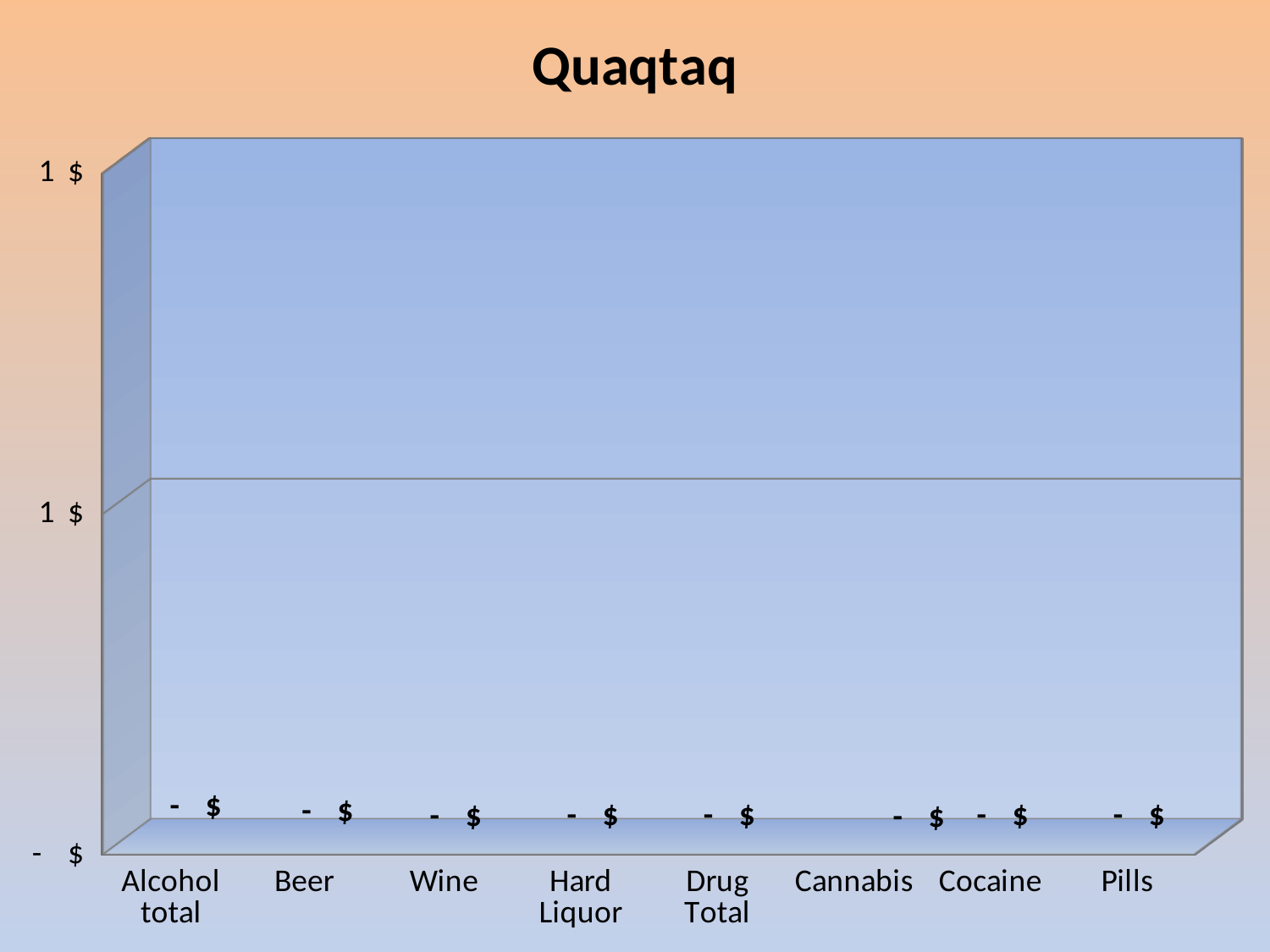
What value is labelled for Hard Liquor? - $ How many categories are shown on the x axis of the chart? 8 What value is labelled for Wine? - $ What value is labelled for Pills? - $ What value is labelled for Beer? - $ What value is labelled for Drug Total? - $ What value is labelled for Cocaine? - $ What is the title of the chart? Quaqtaq What value is labelled for Cannabis? - $ What value is labelled for Alcohol total? - $ Do the values rise, fall, or stay flat across the categories from Alcohol total to Pills? stay flat What kind of chart is shown on the slide? bar chart